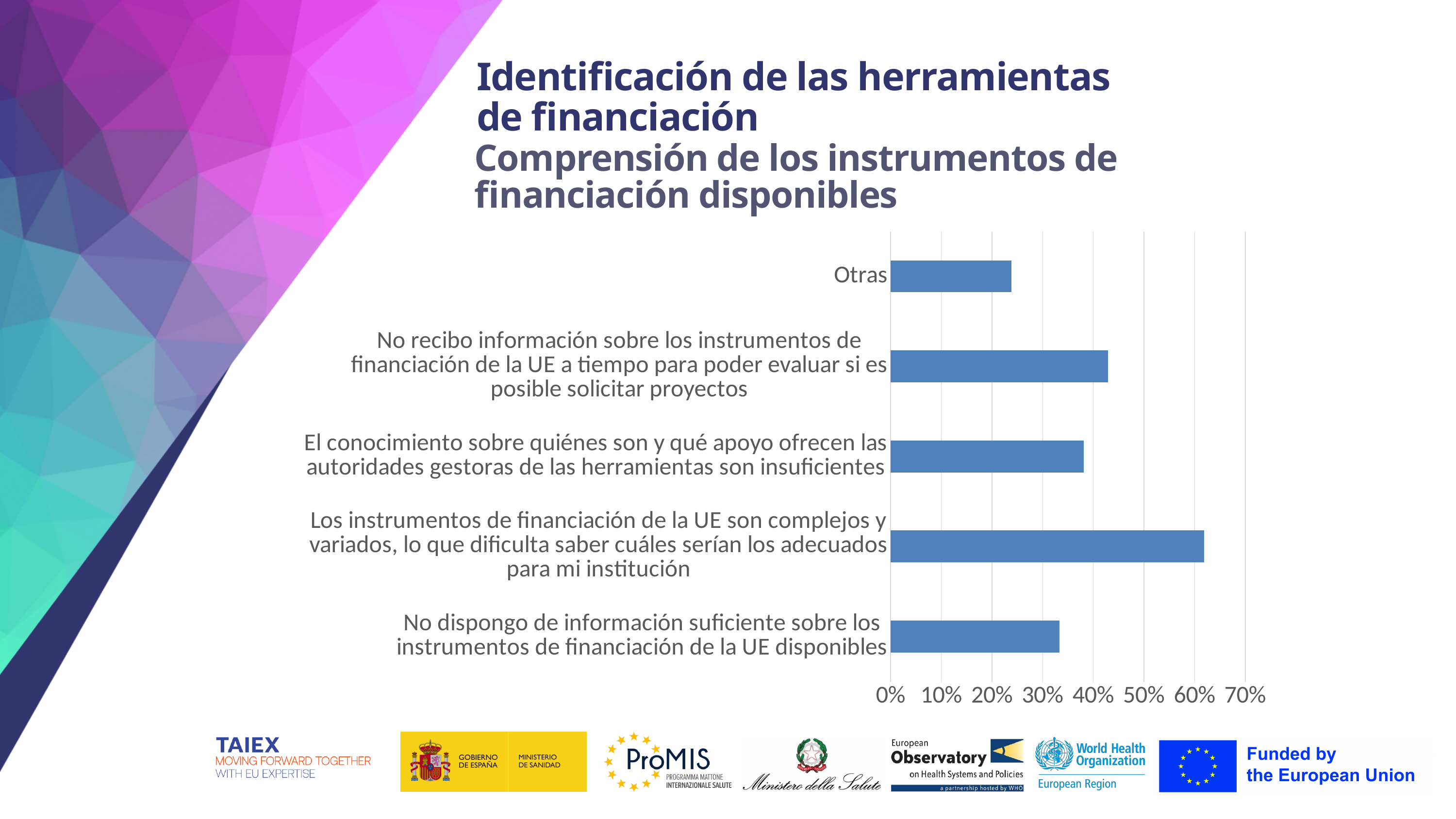
What kind of chart is shown on the slide? bar chart How many categories are plotted in the chart? 5 What is the highest value shown on the chart's horizontal axis? 70% Is the value for "No dispongo de información suficiente sobre los instrumentos de financiación de la UE disponibles" greater or less than 40%? less Is the value for "Los instrumentos de financiación de la UE son complejos y variados..." greater or less than 50%? greater What colour are the bars in the chart? blue Is the value for "Otras" greater or less than 30%? less Which category has the lowest value in the chart? Otras Which category has the highest value in the chart? Los instrumentos de financiación de la UE son complejos y variados, lo que dificulta saber cuáles serían los adecuados para mi institución Which is larger: the value for "No recibo información sobre los instrumentos de financiación de la UE a tiempo..." or the value for "El conocimiento sobre quiénes son y qué apoyo ofrecen las autoridades gestoras..."? No recibo información sobre los instrumentos de financiación de la UE a tiempo para poder evaluar si es posible solicitar proyectos